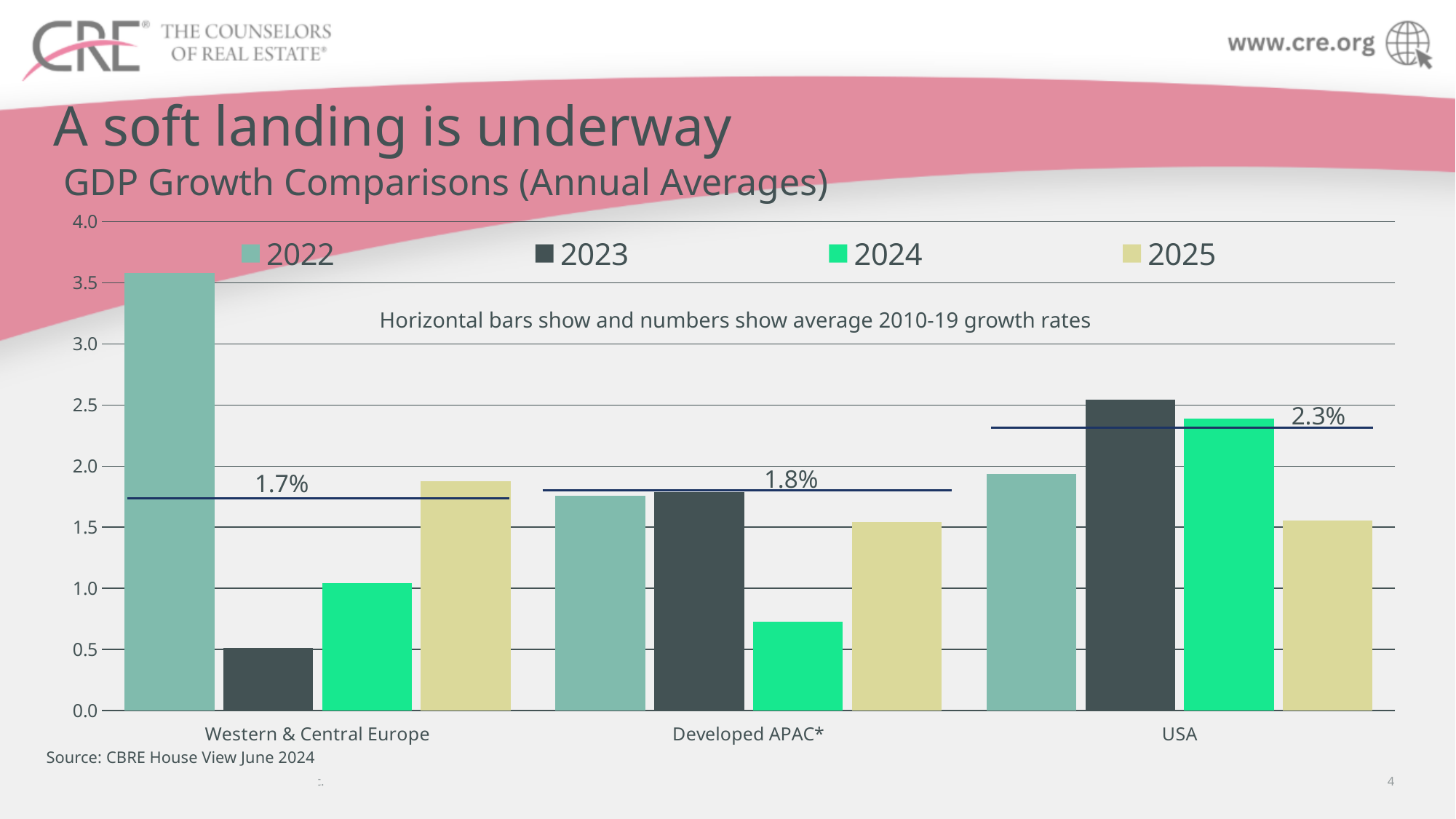
How many regions are shown on the x axis? 3 What kind of chart is shown on the slide? Bar chart What is the difference between the average 2010-19 growth rates shown for the USA and Western & Central Europe? 0.6% What is the average 2010-19 growth rate shown for Developed APAC*? 1.8% For the USA, which is larger: the 2023 bar or the 2025 bar? 2023 Which region has the lowest 2023 bar? Western & Central Europe Is the 2022 value for Western & Central Europe greater or less than 3.0? greater How many series does the legend list? 4 What is the average 2010-19 growth rate shown for Western & Central Europe? 1.7% Which region has the highest 2022 bar? Western & Central Europe Is the 2024 value for Developed APAC* greater or less than 1.0? less What is the average 2010-19 growth rate shown for the USA? 2.3%